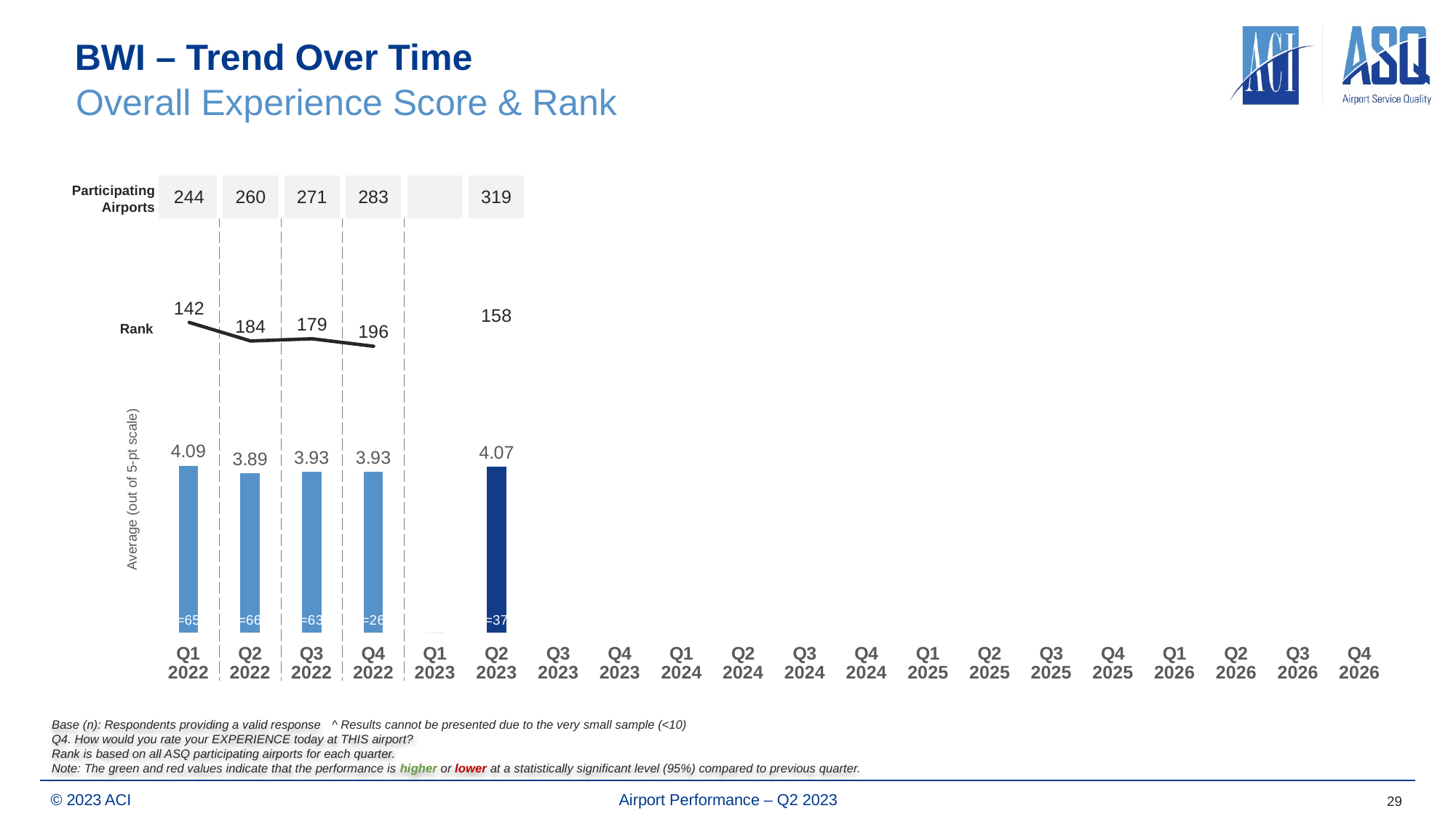
How many participating airports were there in Q2 2023? 319 Which is larger, the Overall Experience Score for Q2 2023 or for Q4 2022? Q2 2023 Which quarter has the highest Overall Experience Score? Q1 2022 What kind of chart is used to show the Overall Experience Score? Bar chart What is the Overall Experience Score for Q1 2022? 4.09 What is the Overall Experience Score for Q2 2023? 4.07 What is the Overall Experience Score for Q2 2022? 3.89 Which quarter has the lowest Overall Experience Score? Q2 2022 How many quarters have an Overall Experience Score bar plotted? 5 What is the difference between the Overall Experience Score in Q1 2022 and Q2 2022? 0.20 What is the difference in participating airports between Q2 2023 and Q1 2022? 75 What is BWI's rank in Q4 2022? 196